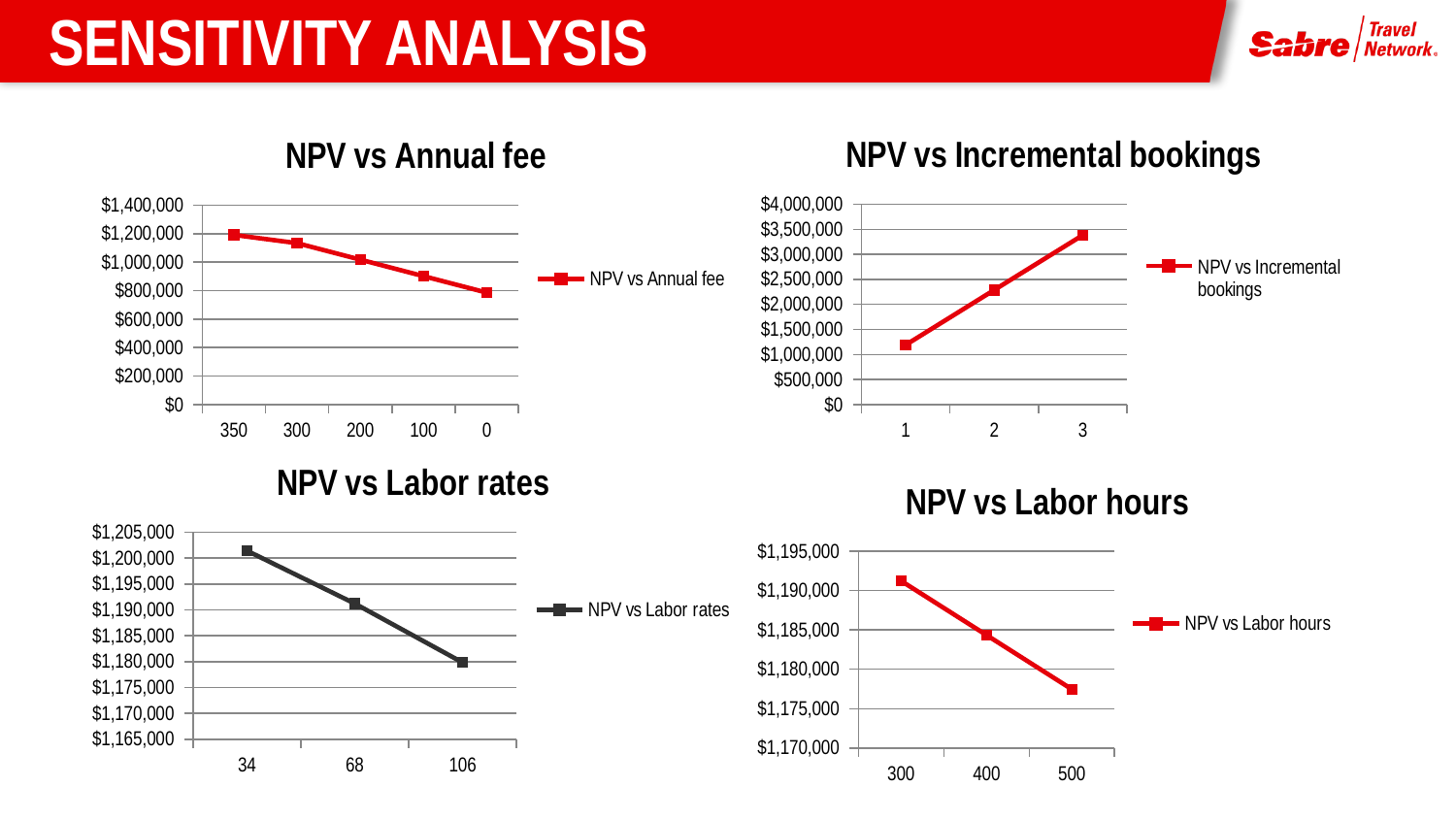
In the 'NPV vs Annual fee' chart, which x-axis category has the highest NPV? 350 In the 'NPV vs Incremental bookings' chart, do the values rise or fall from left to right along the x axis? rise In the 'NPV vs Incremental bookings' chart, which x-axis category has the lowest NPV? 1 In the 'NPV vs Incremental bookings' chart, is the value at 3 greater or less than $3,000,000? greater In the 'NPV vs Labor rates' chart, how many series does the legend list? 1 In the 'NPV vs Annual fee' chart, how many points are plotted along the x axis? 5 In the 'NPV vs Annual fee' chart, is the value at an annual fee of 0 greater or less than $1,000,000? less In the 'NPV vs Labor hours' chart, which is larger, the value at 300 or the value at 500? 300 In the 'NPV vs Annual fee' chart, do the values rise or fall from left to right along the x axis? fall What kind of chart is the 'NPV vs Annual fee' chart? line chart In the 'NPV vs Labor rates' chart, what colour is the plotted line? dark grey In the 'NPV vs Labor rates' chart, is the value at 106 greater or less than $1,190,000? less